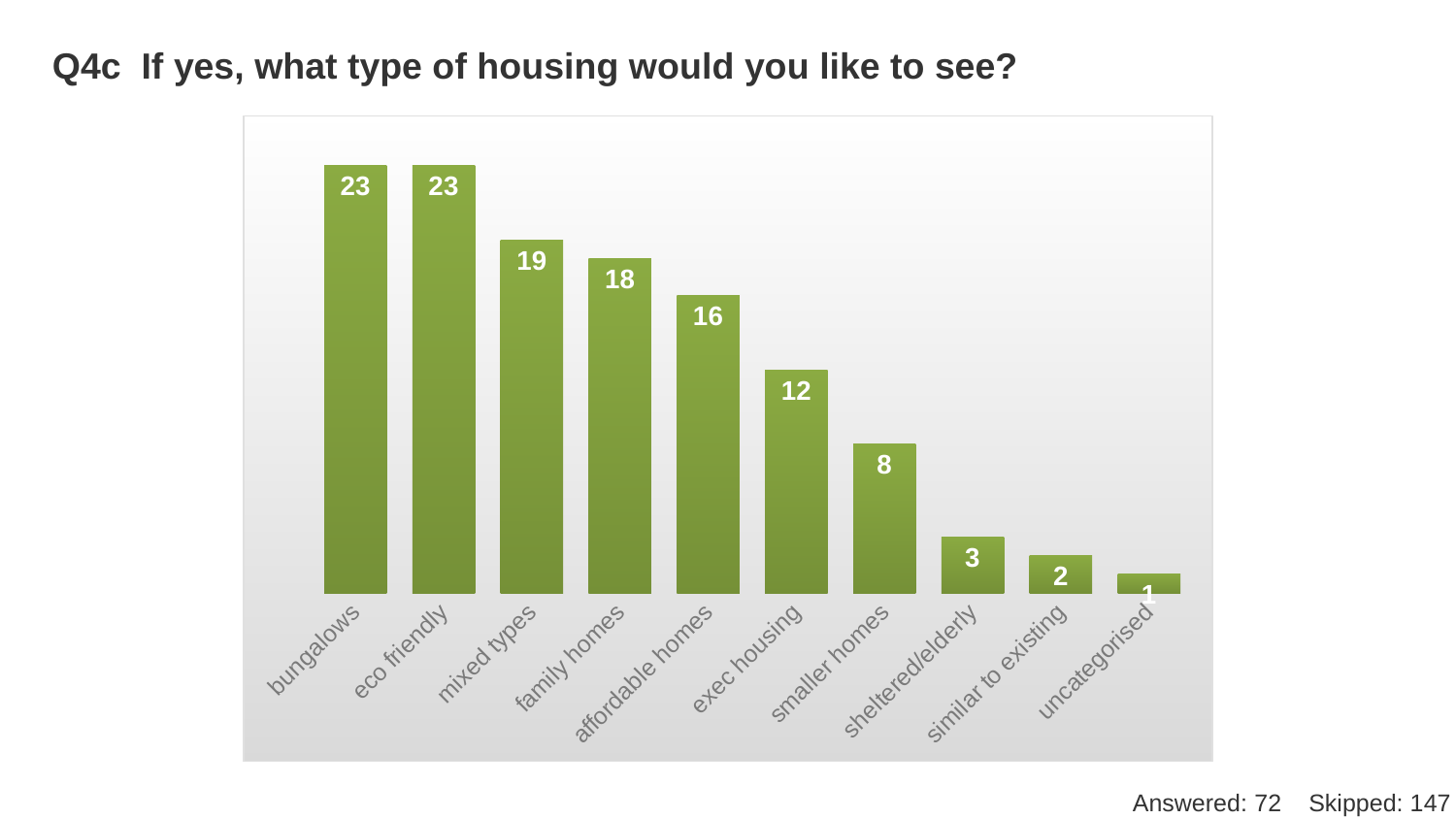
Which category has the lowest value? uncategorised Which is larger, the value for affordable homes or the value for exec housing? affordable homes What is the title of the chart? Q4c If yes, what type of housing would you like to see? What kind of chart is shown on the slide? bar chart What is the value for mixed types? 19 Do the values rise or fall from left to right along the x axis? fall Which two categories share the highest value? bungalows and eco friendly What is the value for sheltered/elderly? 3 What is the difference between the values for family homes and smaller homes? 10 How many categories are shown on the chart? 10 What is the value for exec housing? 12 What is the difference between the values for bungalows and uncategorised? 22